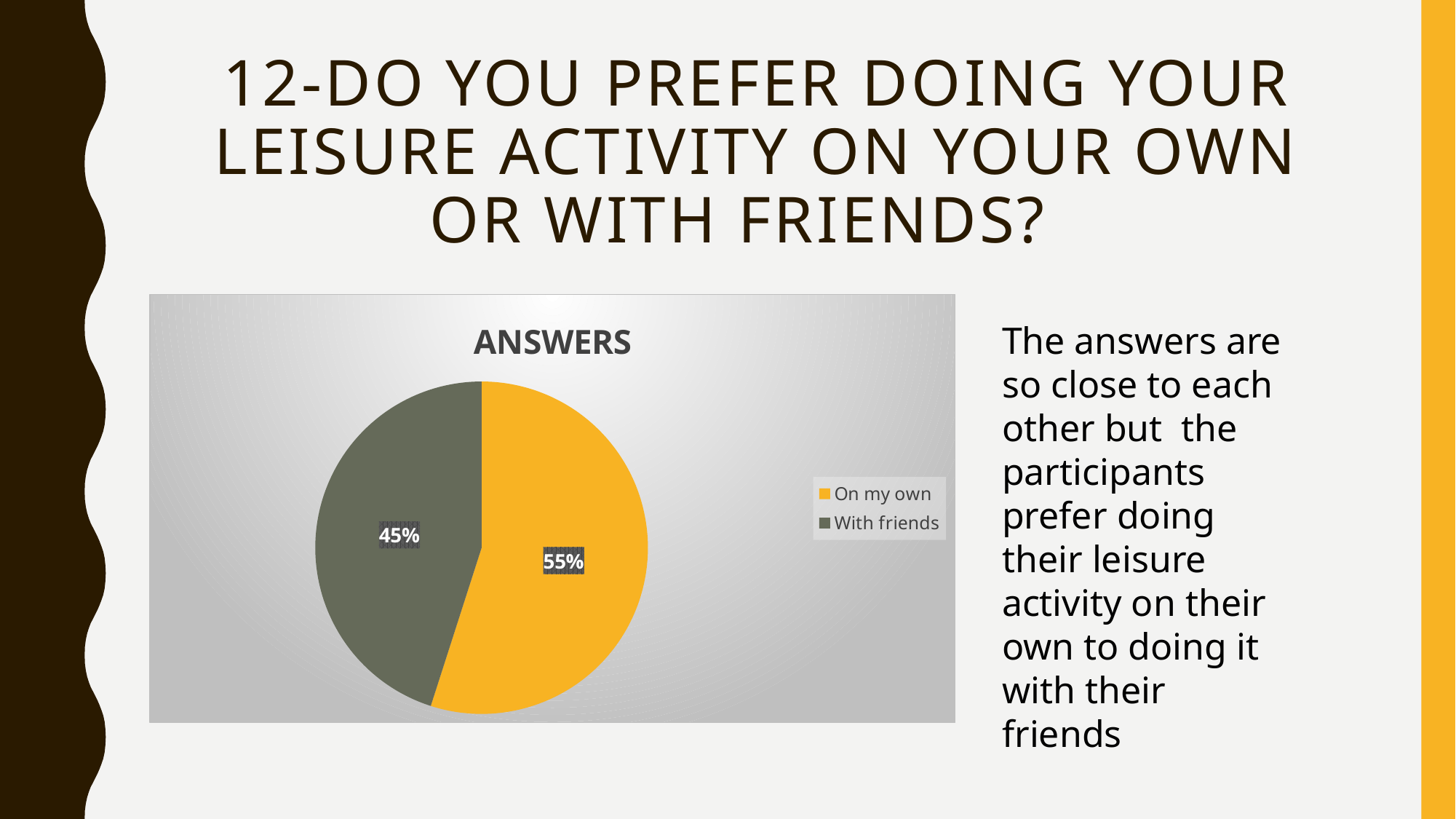
Which is larger, the share for 'On my own' or the share for 'With friends'? On my own What kind of chart is shown on the slide? pie chart What percentage of answers is 'With friends'? 45% What is the chart's title? ANSWERS How many entries does the legend list? 2 How many slices does the pie chart have? 2 What colour is the 'On my own' slice? yellow What percentage of answers is 'On my own'? 55% Which category has the smallest share of the pie? With friends Which category has the largest share of the pie? On my own What is the difference in percentage points between 'On my own' and 'With friends'? 10 What share of the pie does the 'With friends' slice represent? 45%